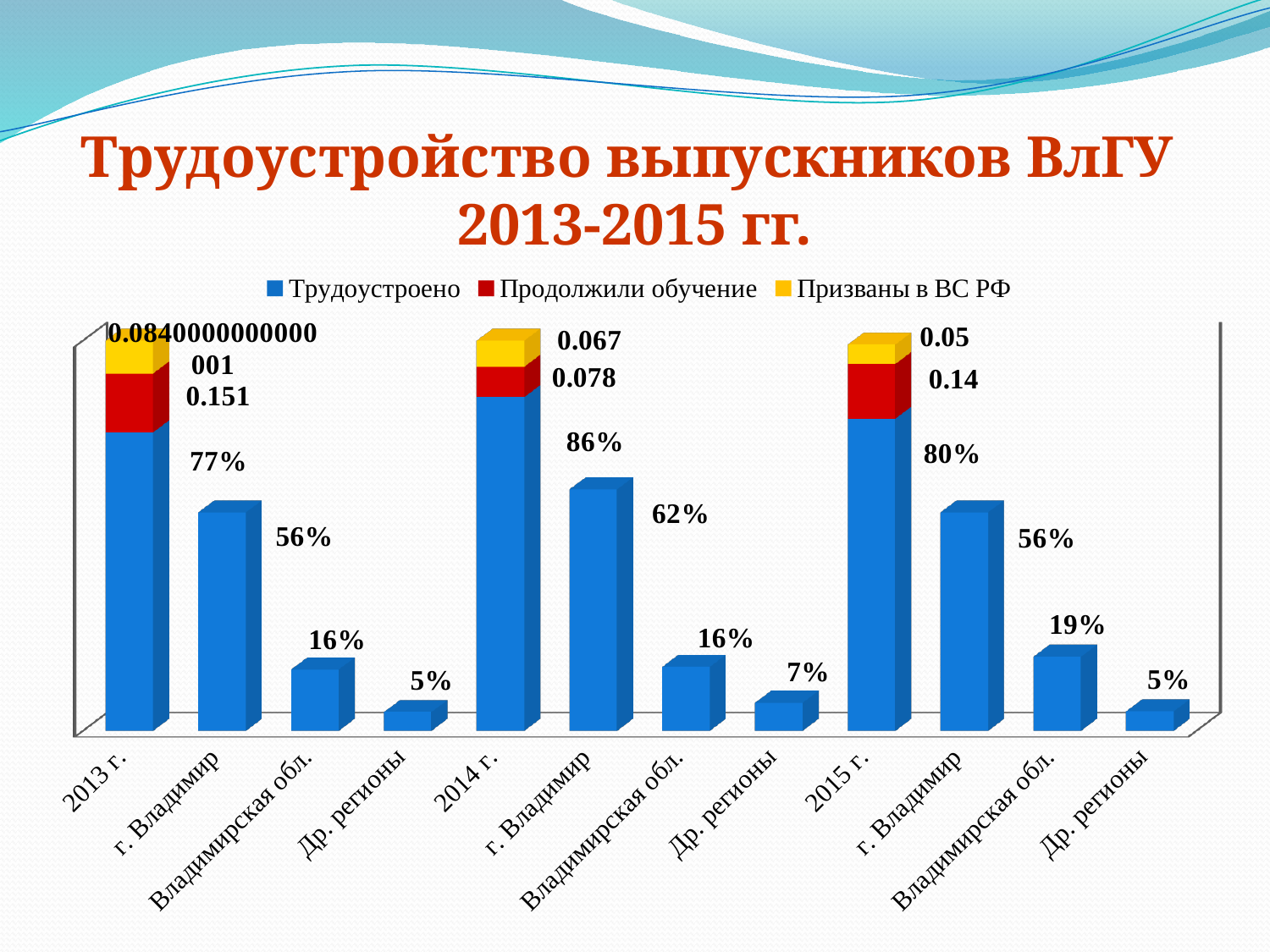
What is the Трудоустроено value for the 2014 г. bar? 86% How many categories are shown along the x axis? 12 Which year bar (2013 г., 2014 г. or 2015 г.) has the highest Трудоустроено value? 2014 г. What is the difference between the Трудоустроено values for 2014 г. and 2013 г.? 9% What is the title of the chart on the slide? Трудоустройство выпускников ВлГУ 2013-2015 гг. How many series does the legend list? 3 Which is larger: the value for Др. регионы in the 2014 group or in the 2015 group? 2014 group (7%) What kind of chart is shown on the slide? bar chart What is the Продолжили обучение value for the 2015 г. bar? 0.14 What is the value for г. Владимир in the 2014 group? 62% What is the Призваны в ВС РФ value for the 2014 г. bar? 0.067 What is the value for Владимирская обл. in the 2015 group? 19%